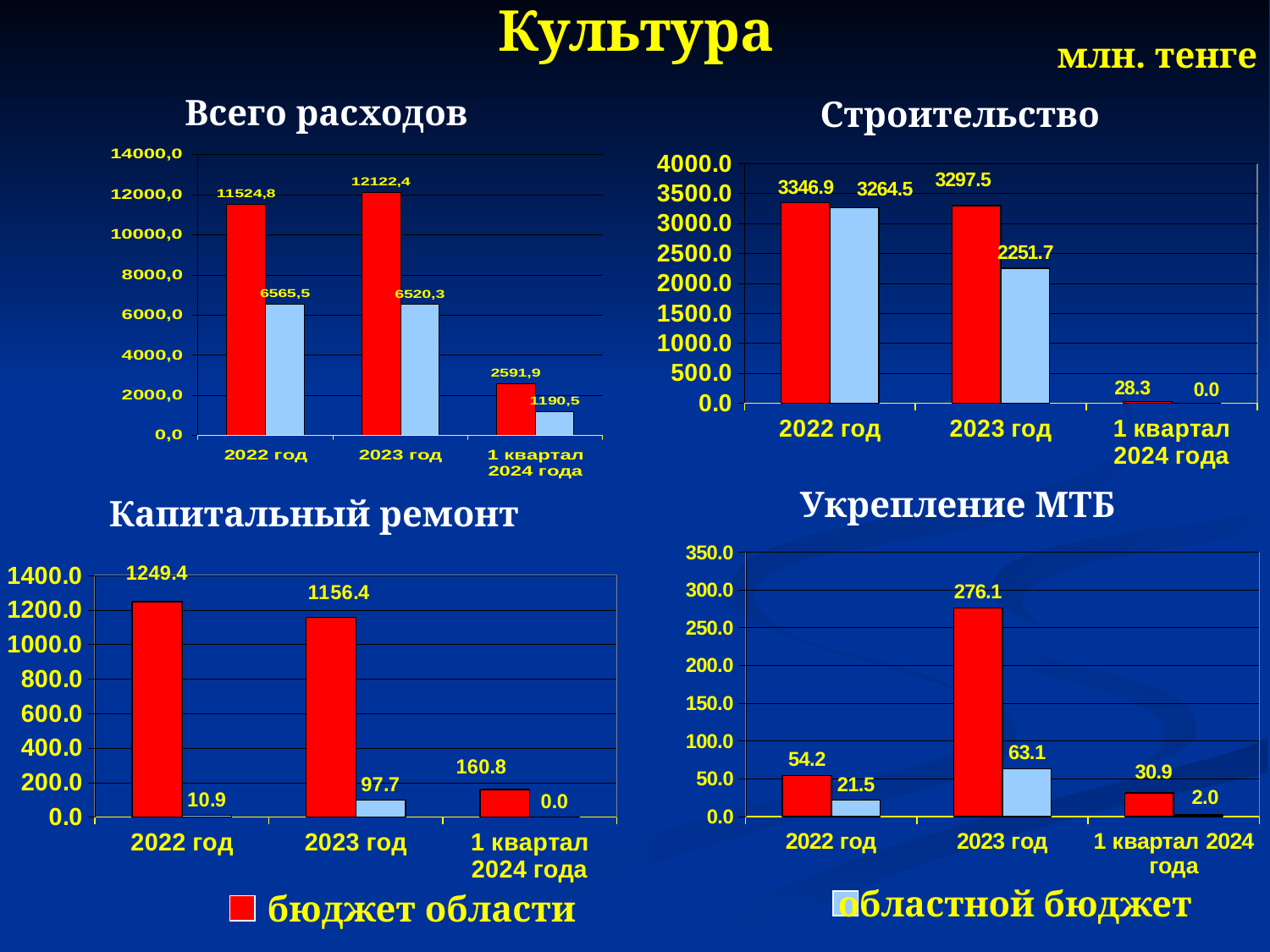
According to the legend at the bottom of the slide, which series is shown in red? бюджет области How many categories are shown on the x axis of the 'Строительство' chart? 3 What type of chart is 'Всего расходов'? bar chart In the 'Всего расходов' chart, what is the value of the red bar for 2023 год? 12122,4 In the 'Укрепление МТБ' chart, what is the difference between the red and light blue bars for 2023 год? 213.0 In the 'Капитальный ремонт' chart, what is the value of the light blue bar for 2023 год? 97.7 In the 'Строительство' chart, what is the difference between the red and light blue bars for 2023 год? 1045.8 In the 'Строительство' chart, what is the value of the light blue bar for 2023 год? 2251.7 In the 'Укрепление МТБ' chart, which is larger for 2022 год: the red bar or the light blue bar? the red bar In the 'Капитальный ремонт' chart, which category has the highest red bar? 2022 год In the 'Укрепление МТБ' chart, what is the value of the red bar for 2023 год? 276.1 In the 'Всего расходов' chart, what is the value of the light blue bar for 1 квартал 2024 года? 1190,5